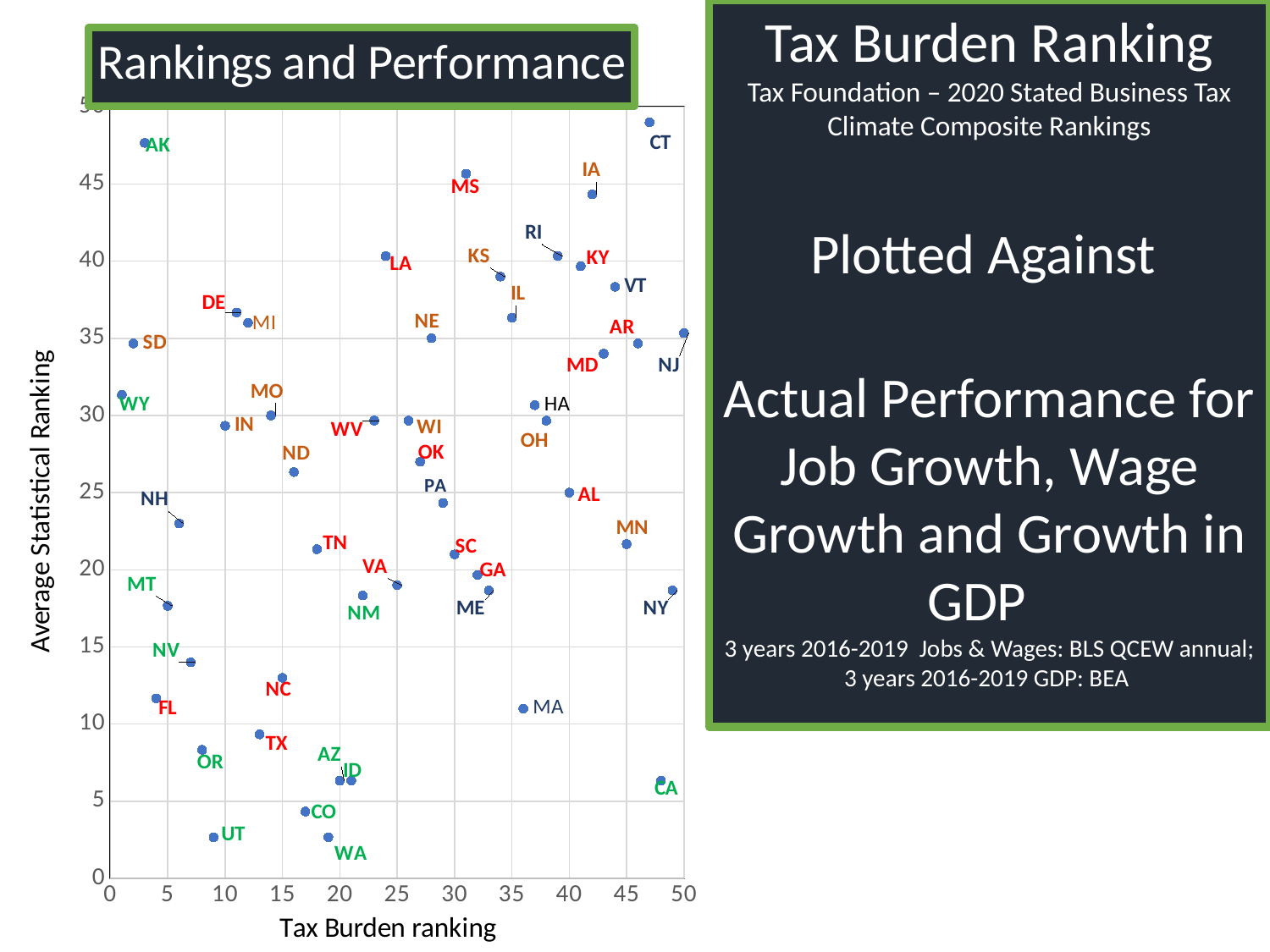
Is the Average Statistical Ranking for AK greater or less than 45? greater Is the Tax Burden ranking for CA greater or less than 45? greater Which state has the highest Average Statistical Ranking on the chart? CT Which has the higher Average Statistical Ranking, FL or TN? TN What is the title of the y axis of the chart? Average Statistical Ranking Is the Average Statistical Ranking for MA greater or less than 15? less What is the title of the x axis of the chart? Tax Burden ranking Which has the larger Tax Burden ranking, WY or NJ? NJ Which has the higher Average Statistical Ranking, MS or LA? MS What kind of chart is shown on the slide? Scatter plot